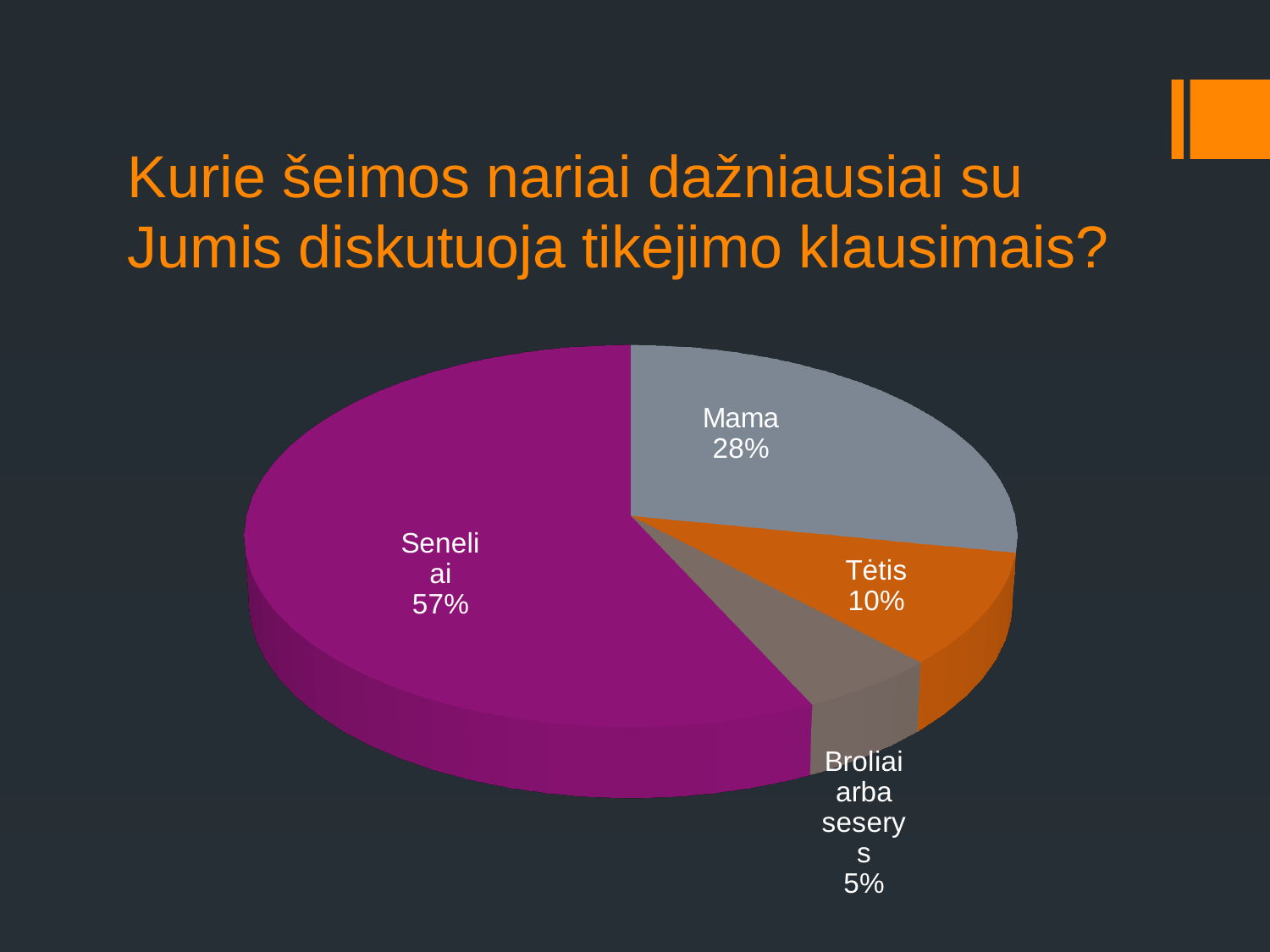
What kind of chart is shown on the slide? pie chart What share of the pie does Mama have? 28% How many slices does the pie chart have? 4 Which is larger, the share for Mama or the share for Tėtis? Mama What is the difference in percentage points between Tėtis and Broliai arba seserys? 5 What share of the pie does Tėtis have? 10% Which category has the smallest slice of the pie? Broliai arba seserys What share of the pie does Seneliai have? 57% What is the difference in percentage points between Seneliai and Mama? 29 What colour is the Seneliai slice? purple Which category has the largest slice of the pie? Seneliai